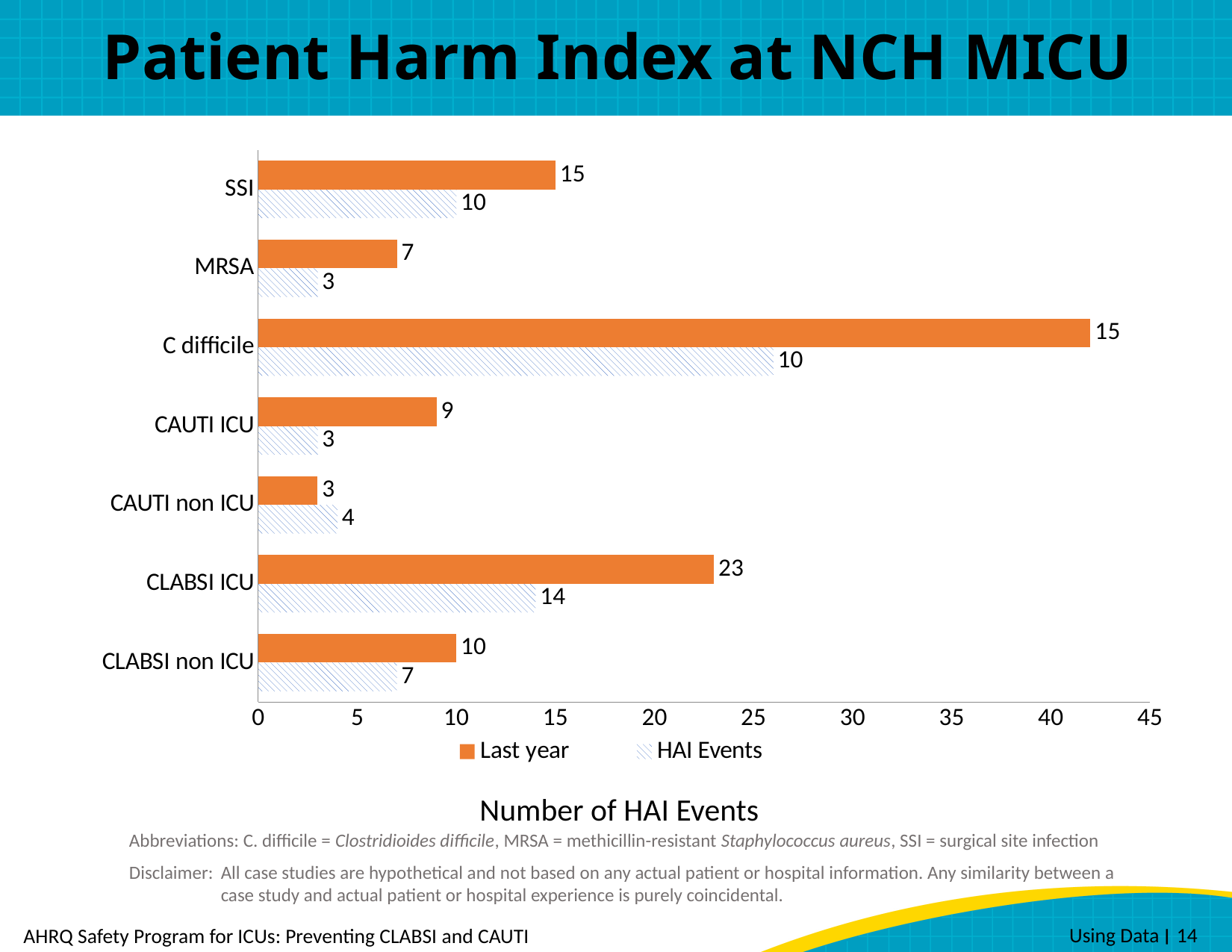
What is the difference between the Last year and HAI Events values for CLABSI ICU? 9 Is the Last year value for CLABSI ICU greater or less than 20? greater Which category has the lowest Last year value? CAUTI non ICU How many series does the legend list? 2 What is the difference between the Last year and HAI Events values for CLABSI non ICU? 3 What is the HAI Events value for CAUTI non ICU? 4 What is the HAI Events value for SSI? 10 What kind of chart is shown on the slide? Bar chart What is the Last year value for CLABSI ICU? 23 What is the Last year value for MRSA? 7 How many categories are shown on the chart? 7 For CAUTI non ICU, which series has the larger value, Last year or HAI Events? HAI Events